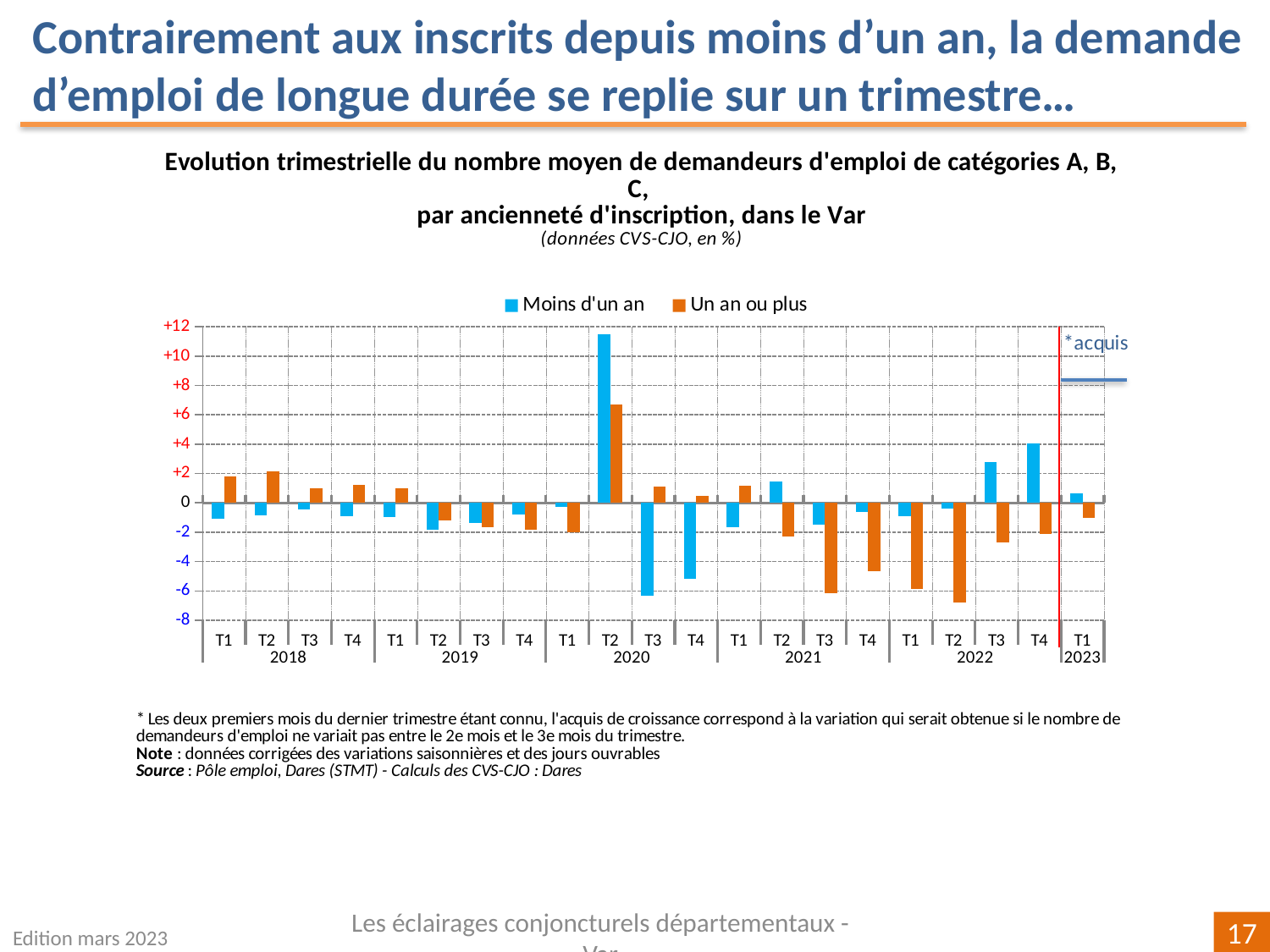
In T4 2022, which series has the larger value, 'Moins d'un an' or 'Un an ou plus'? Moins d'un an In which quarter is the value for 'Moins d'un an' highest? T2 2020 Is the value for 'Moins d'un an' in T4 2022 greater or less than +2? greater In which quarter is the value for 'Moins d'un an' lowest? T3 2020 Is the value for 'Moins d'un an' in T2 2020 greater or less than +10? greater How many quarters are plotted along the x axis? 21 How many series does the legend list? 2 What kind of chart is shown on the slide? bar chart In which quarter is the value for 'Un an ou plus' highest? T2 2020 What are the two series named in the legend? Moins d'un an; Un an ou plus What label is shown next to the red vertical line at the right of the chart? *acquis Is the value for 'Un an ou plus' in T3 2021 greater or less than -4? less